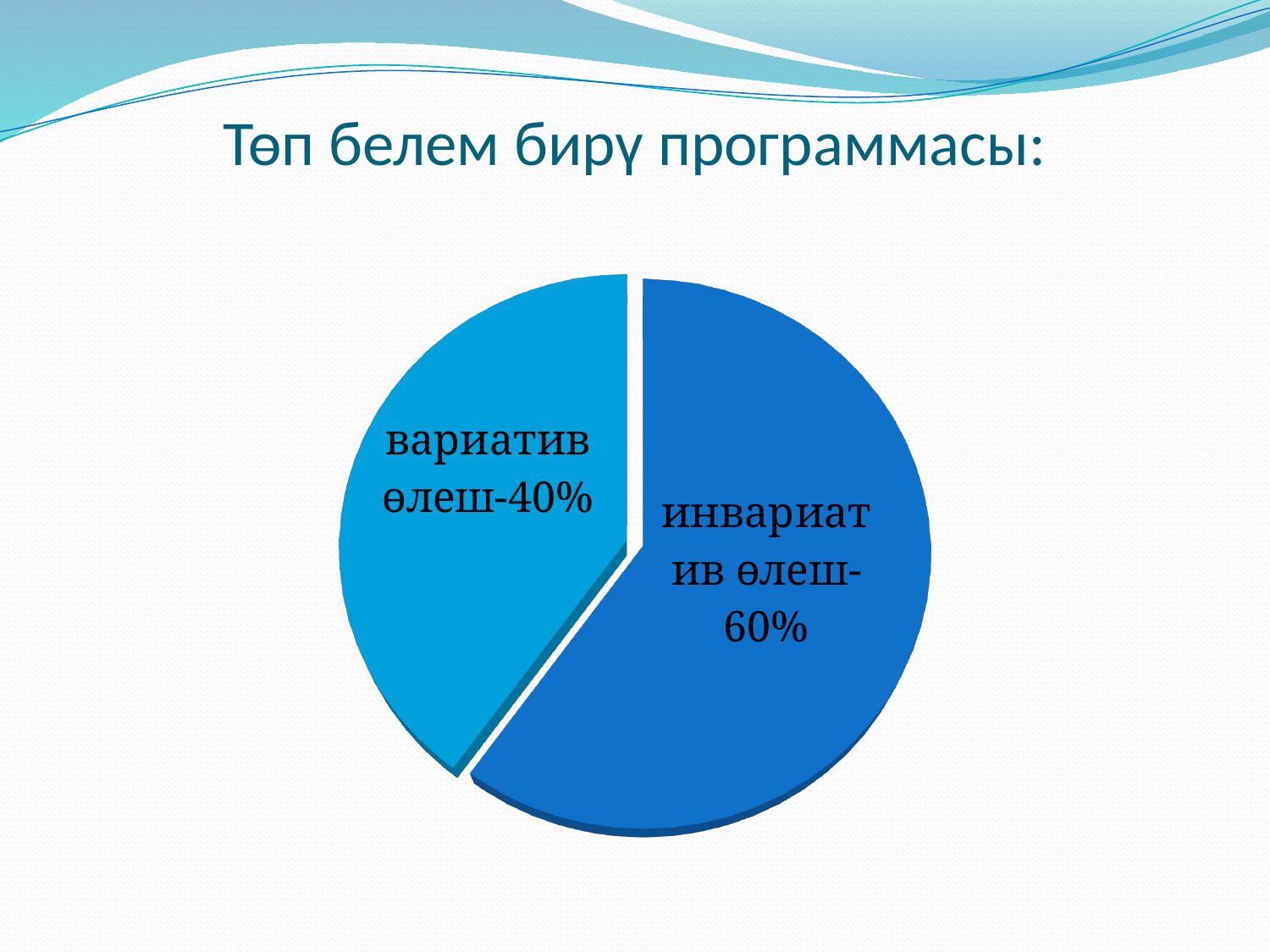
Which slice is drawn in the lighter blue colour? вариатив өлеш What is the title of the slide containing the pie chart? Төп белем бирү программасы: Which is larger, the "вариатив өлеш" slice or the "инвариатив өлеш" slice? инвариатив өлеш What kind of chart is shown on the slide? pie chart Which slice of the pie is the smallest? вариатив өлеш What is the value shown for the slice labelled "вариатив өлеш"? 40% Which slice of the pie is the largest? инвариатив өлеш What is the value shown for the slice labelled "инвариатив өлеш"? 60% What is the difference between the "инвариатив өлеш" and "вариатив өлеш" slices? 20% What share of the pie does the "инвариатив өлеш" slice represent? 60% How many slices does the pie chart have? 2